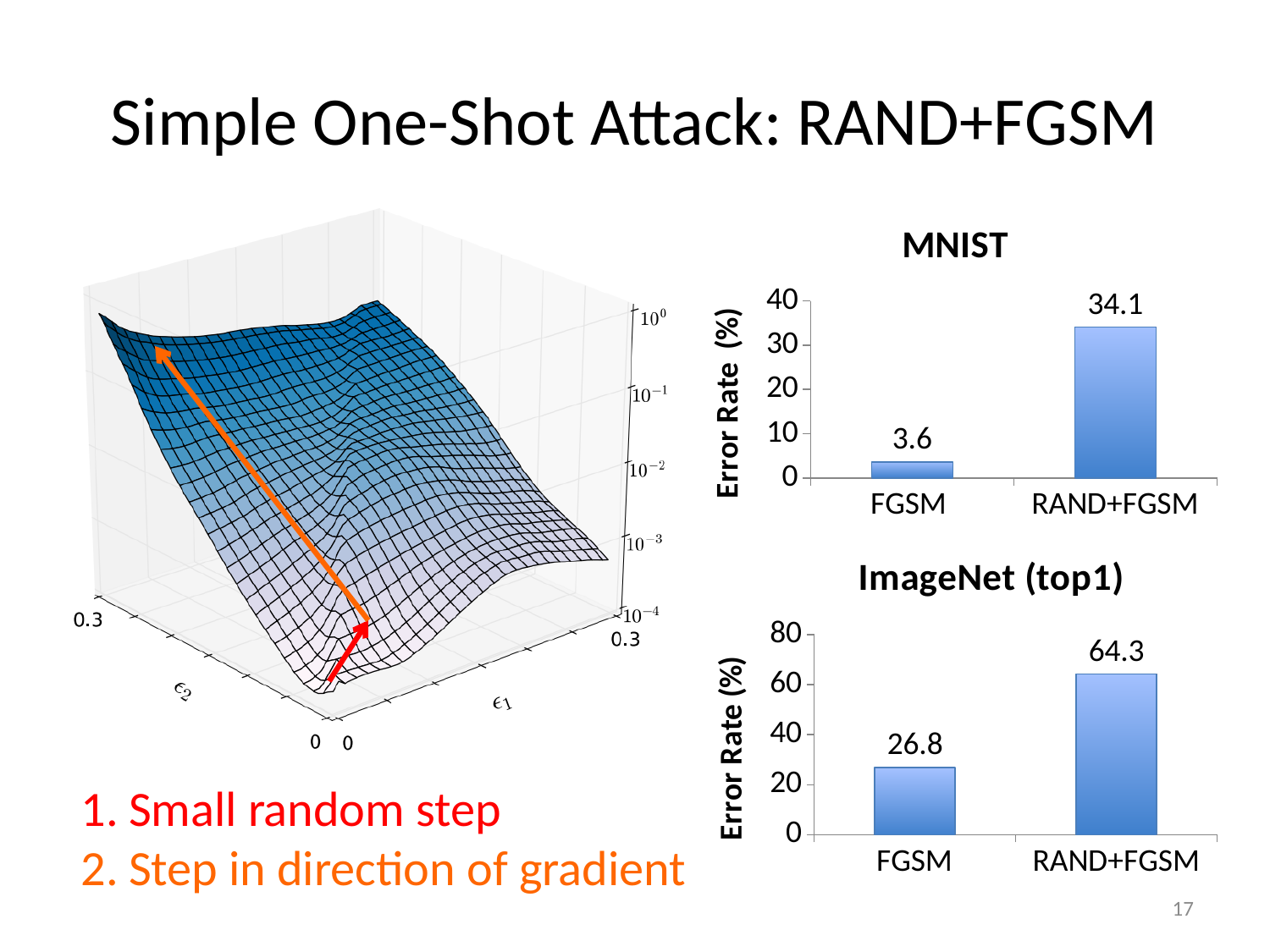
In the MNIST chart, what is the difference in error rate between RAND+FGSM and FGSM? 30.5 What kind of chart is the ImageNet (top1) chart? bar chart In the MNIST chart, what is the error rate for FGSM? 3.6 In the ImageNet (top1) chart, what is the error rate for FGSM? 26.8 What is the y-axis label of the MNIST chart? Error Rate (%) In the ImageNet (top1) chart, what is the error rate for RAND+FGSM? 64.3 In the MNIST chart, which attack has the higher error rate? RAND+FGSM In the ImageNet (top1) chart, which attack has the lower error rate? FGSM How many categories are shown in the MNIST chart? 2 In the ImageNet (top1) chart, what is the difference in error rate between RAND+FGSM and FGSM? 37.5 In the ImageNet (top1) chart, is the error rate for RAND+FGSM greater or less than 60? greater In the MNIST chart, what is the error rate for RAND+FGSM? 34.1